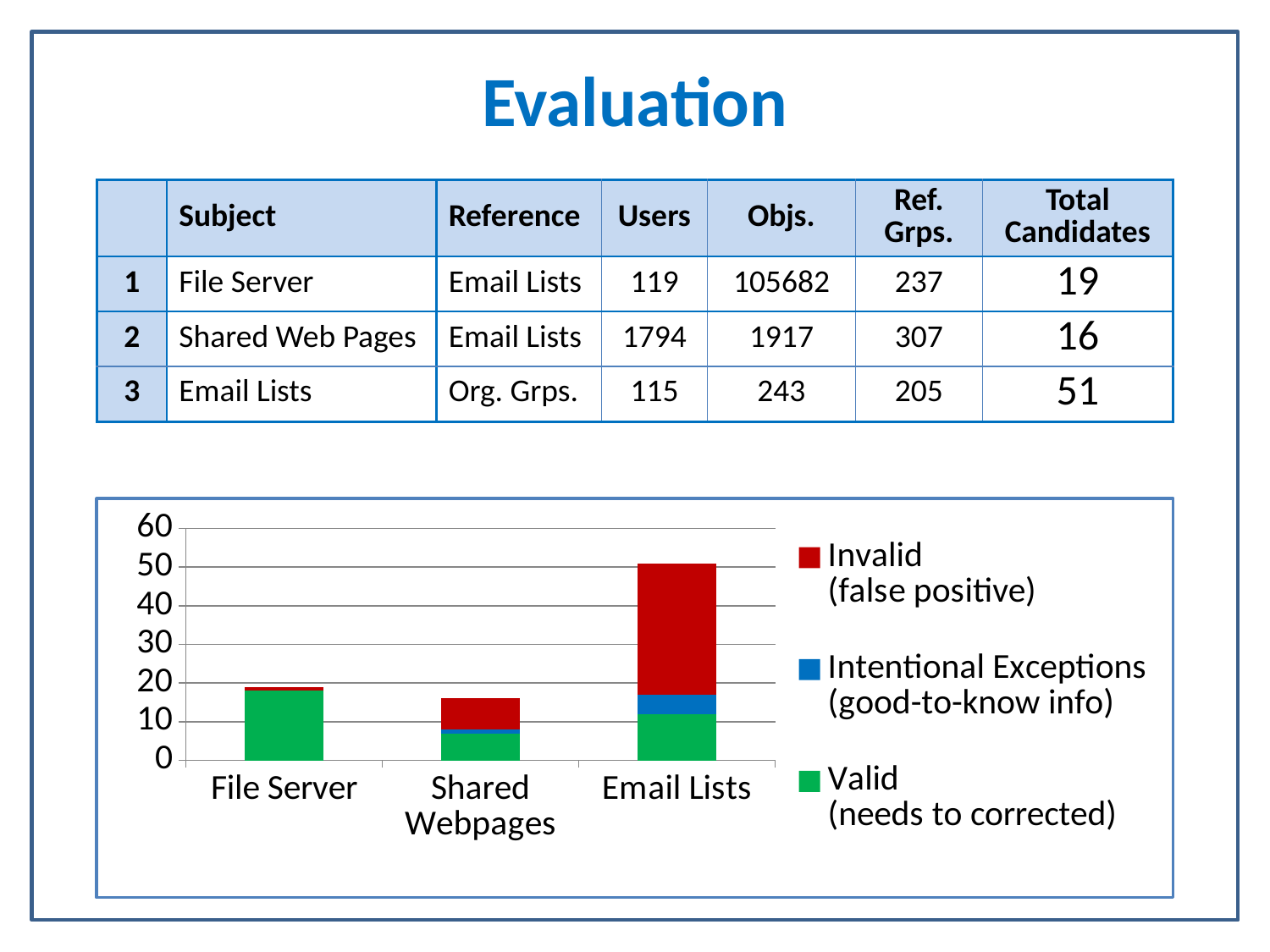
Which series is shown in green in the chart's legend? Valid (needs to corrected) Is the total height of the Email Lists bar greater or less than 40? greater What kind of chart is shown on the slide? Stacked bar chart Which category has the shortest stacked bar in the chart? Shared Webpages Which series is shown in red in the chart's legend? Invalid (false positive) How many categories are shown on the x axis of the chart? 3 Is the total height of the File Server bar greater or less than 10? greater Is the Invalid (false positive) segment of the Email Lists bar greater or less than 30? greater Which stacked bar is taller, File Server or Shared Webpages? File Server Which category has the tallest stacked bar in the chart? Email Lists How many series does the chart's legend list? 3